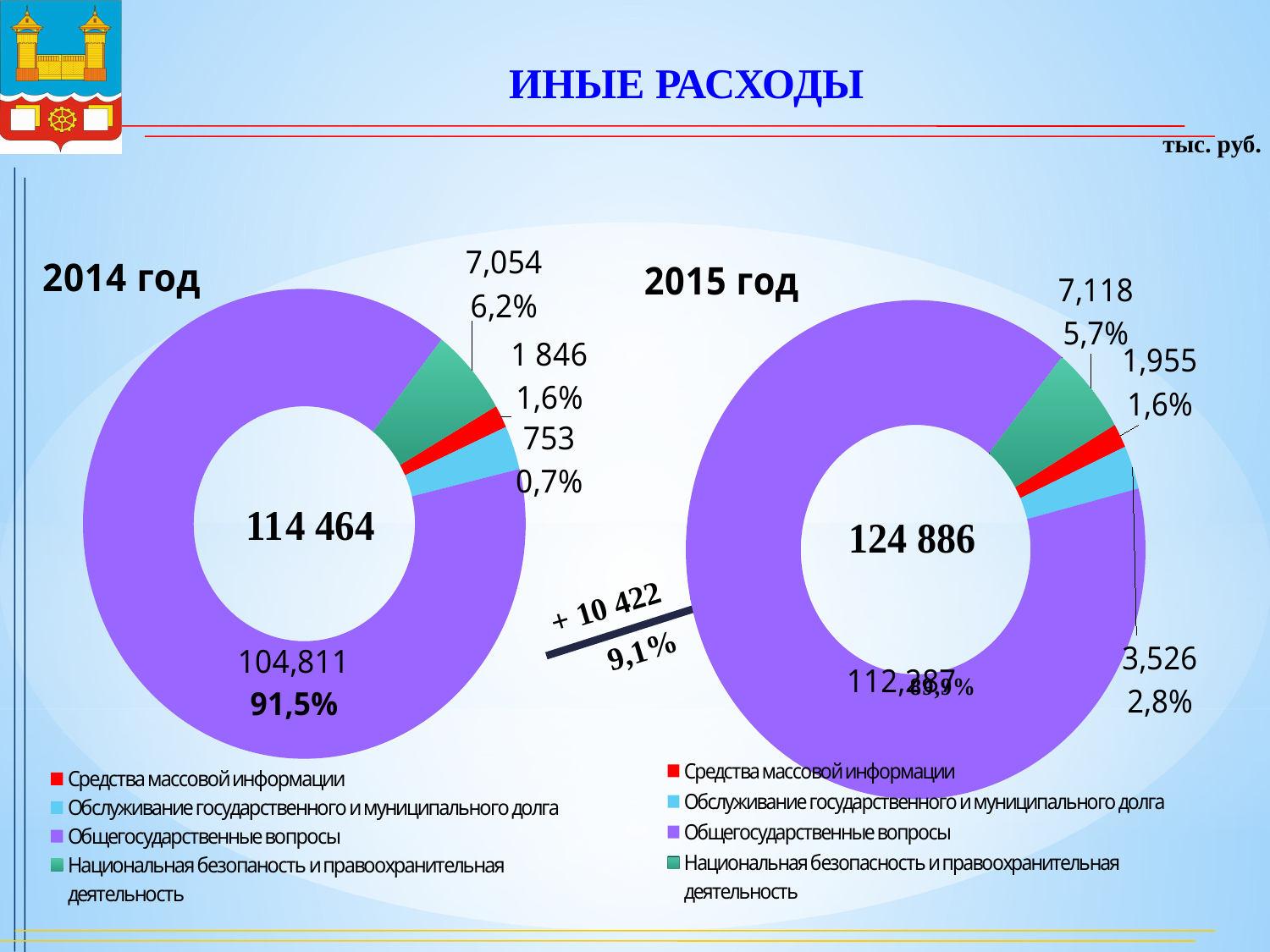
In the 2014 год chart, what is the value for Обслуживание государственного и муниципального долга? 753 In the 2014 год chart, what is the value for Национальная безопасность и правоохранительная деятельность? 7,054 In the 2015 год chart, what is the value for Средства массовой информации? 1,955 What is the difference between the 2015 год total (124 886) and the 2014 год total (114 464) shown in the centres of the charts? 10 422 What kind of chart is used for the 2014 год and 2015 год data on the slide? doughnut chart In the 2014 год chart, which category has the smallest value? Обслуживание государственного и муниципального долга In the 2015 год chart, what share does Национальная безопасность и правоохранительная деятельность have? 5,7% How many categories does the legend of the 2014 год chart list? 4 In the 2014 год chart, what share does Общегосударственные вопросы have? 91,5% In the 2015 год chart, what is the value for Обслуживание государственного и муниципального долга? 3,526 In the 2015 год chart, which category has the largest value? Общегосударственные вопросы In the 2015 год chart, which is larger: Средства массовой информации or Обслуживание государственного и муниципального долга? Обслуживание государственного и муниципального долга